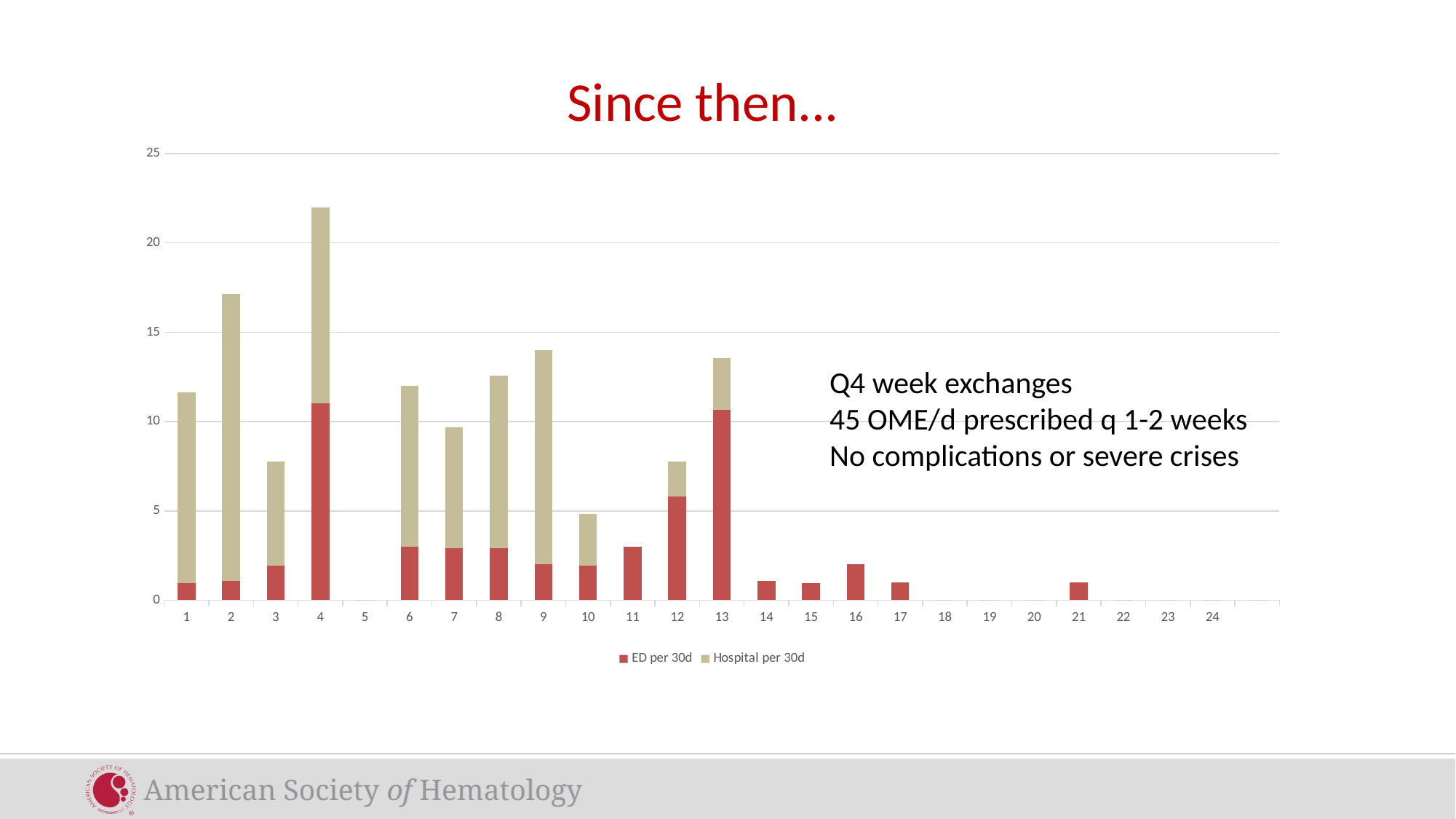
Which category has the tallest stacked bar? 4 What is the title of the slide containing the chart? Since then... Do the stacked bar totals generally rise or fall moving from category 1 to category 24? fall Is the ED per 30d value for category 13 greater or less than 10? greater What kind of chart is shown on the slide? Stacked bar chart What are the two series named in the legend? ED per 30d and Hospital per 30d Which has the larger total stacked value, category 9 or category 10? 9 How many labeled categories are shown on the x axis? 24 How many series does the legend list? 2 Is the total stacked value for category 4 greater or less than 20? greater Is the total stacked value for category 2 greater or less than 15? greater